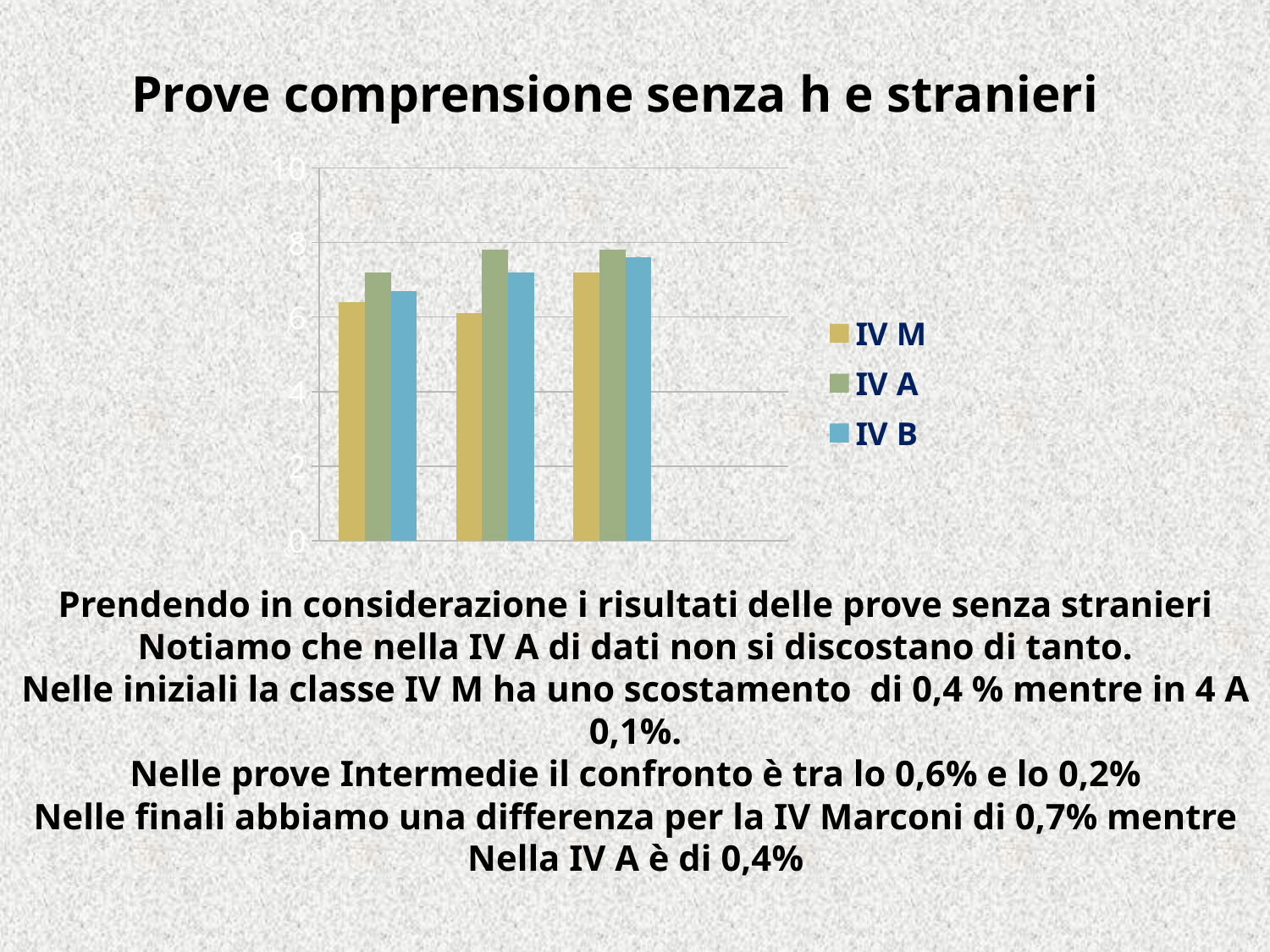
How many series does the chart legend list? 3 In the second group of bars from the left, which series has the lowest bar? IV M What is the title shown above the chart? Prove comprensione senza h e stranieri In the second group of bars from the left, which series has the highest bar? IV A How many groups of bars are plotted in the chart? 3 In the first group of bars from the left, which is larger, IV A or IV M? IV A In the third group of bars from the left, which is larger, IV M or IV A? IV A What kind of chart is shown on the slide? bar chart In the first group of bars from the left, is the value for IV M greater or less than 8? less In the second group of bars from the left, is the value for IV A greater or less than 6? greater In the second group of bars from the left, is the value for IV M greater or less than 8? less What are the series names listed in the chart legend? IV M, IV A, IV B